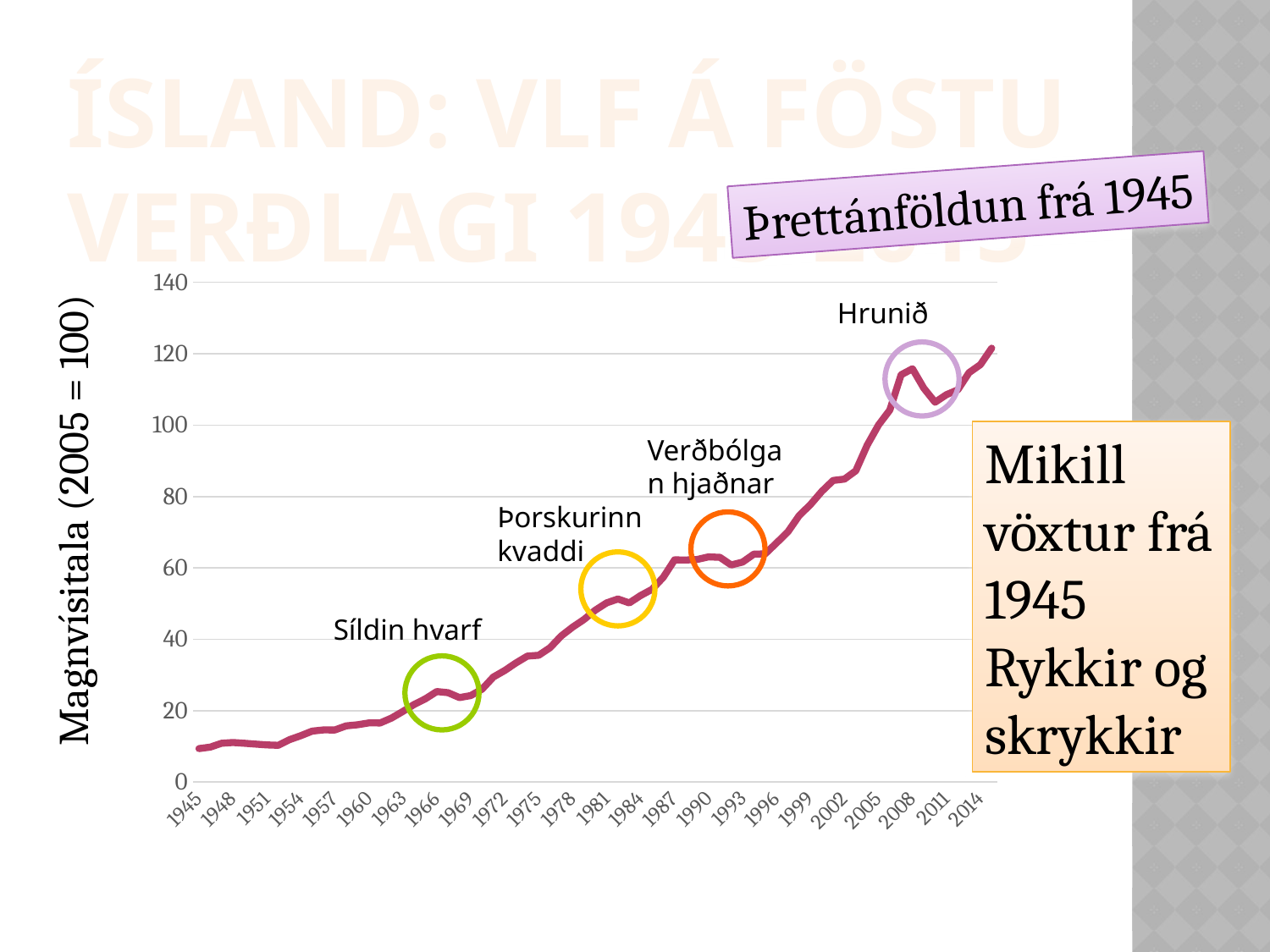
Which year has a higher value, 2008 or 1999? 2008 Which annotation is placed at the circled dip around 2008–2011? Hrunið Is the value for 1945 greater or less than 20? less Is the value for 2014 greater or less than 100? greater How many circled events are annotated on the line? 4 What is the label on the vertical axis of the chart? Magnvísitala (2005 = 100) Is the value for 1966 greater or less than 20? greater Which year has a higher value, 1966 or 1984? 1984 Does the plotted index generally rise or fall from 1945 to 2014? rise What kind of chart is shown on the slide? line chart